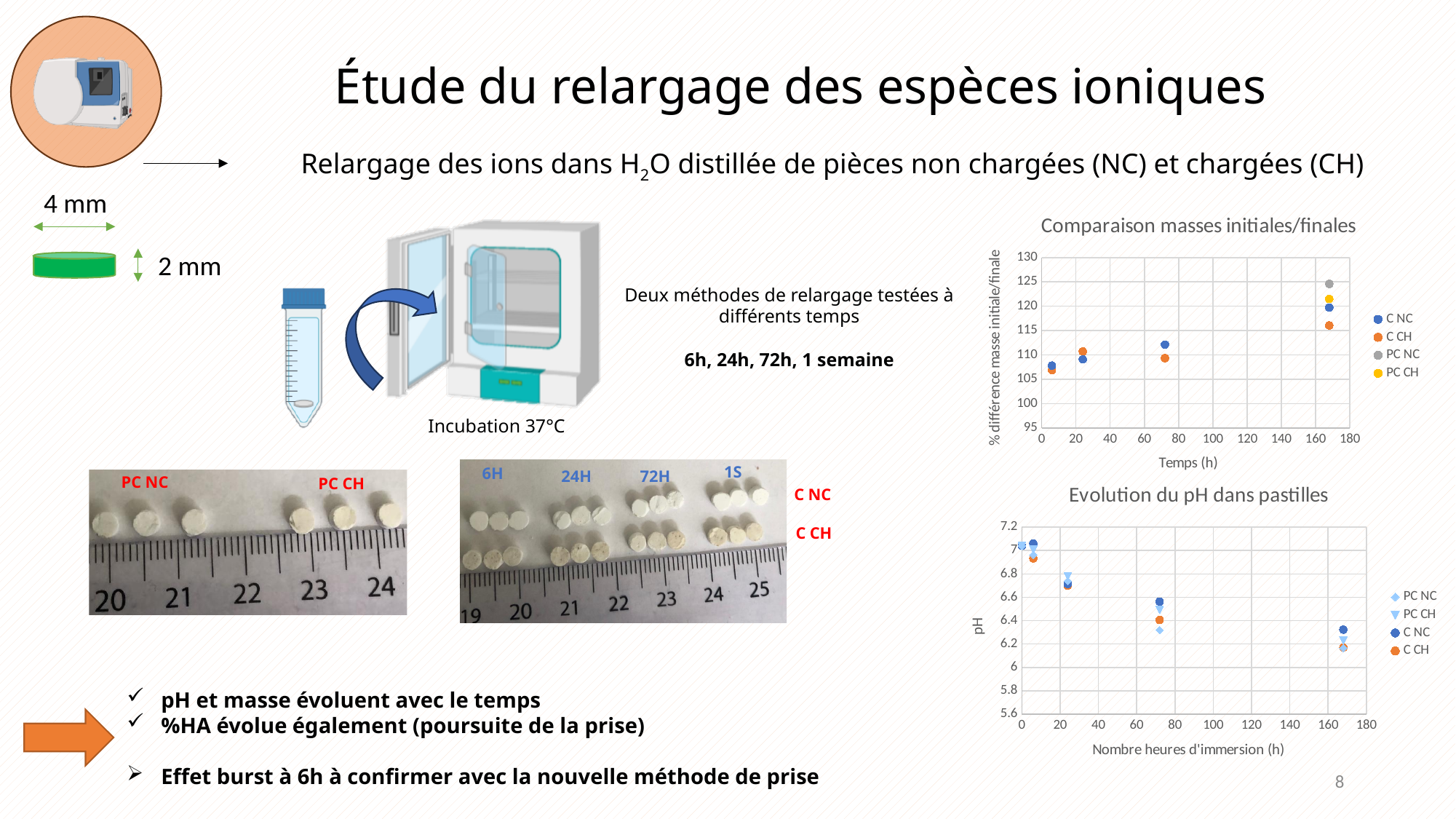
In "Evolution du pH dans pastilles", do the pH values rise or fall as immersion time increases? fall What kind of chart is "Evolution du pH dans pastilles"? scatter chart How many series does the legend of "Evolution du pH dans pastilles" list? 4 In "Comparaison masses initiales/finales", which series has the highest value at about 168 h? PC NC In "Comparaison masses initiales/finales", do the values rise or fall as time increases? rise In "Evolution du pH dans pastilles", is the C NC value at about 72 h greater or less than 6.4? greater In "Comparaison masses initiales/finales", at about 168 h, which is larger: PC NC or C CH? PC NC How many series does the legend of "Comparaison masses initiales/finales" list? 4 In "Comparaison masses initiales/finales", is the C CH value at about 168 h greater or less than 120? less In "Comparaison masses initiales/finales", is the PC NC value at about 168 h greater or less than 120? greater What is the y-axis title of "Comparaison masses initiales/finales"? % différence masse initiale/finale What kind of chart is "Comparaison masses initiales/finales"? scatter chart